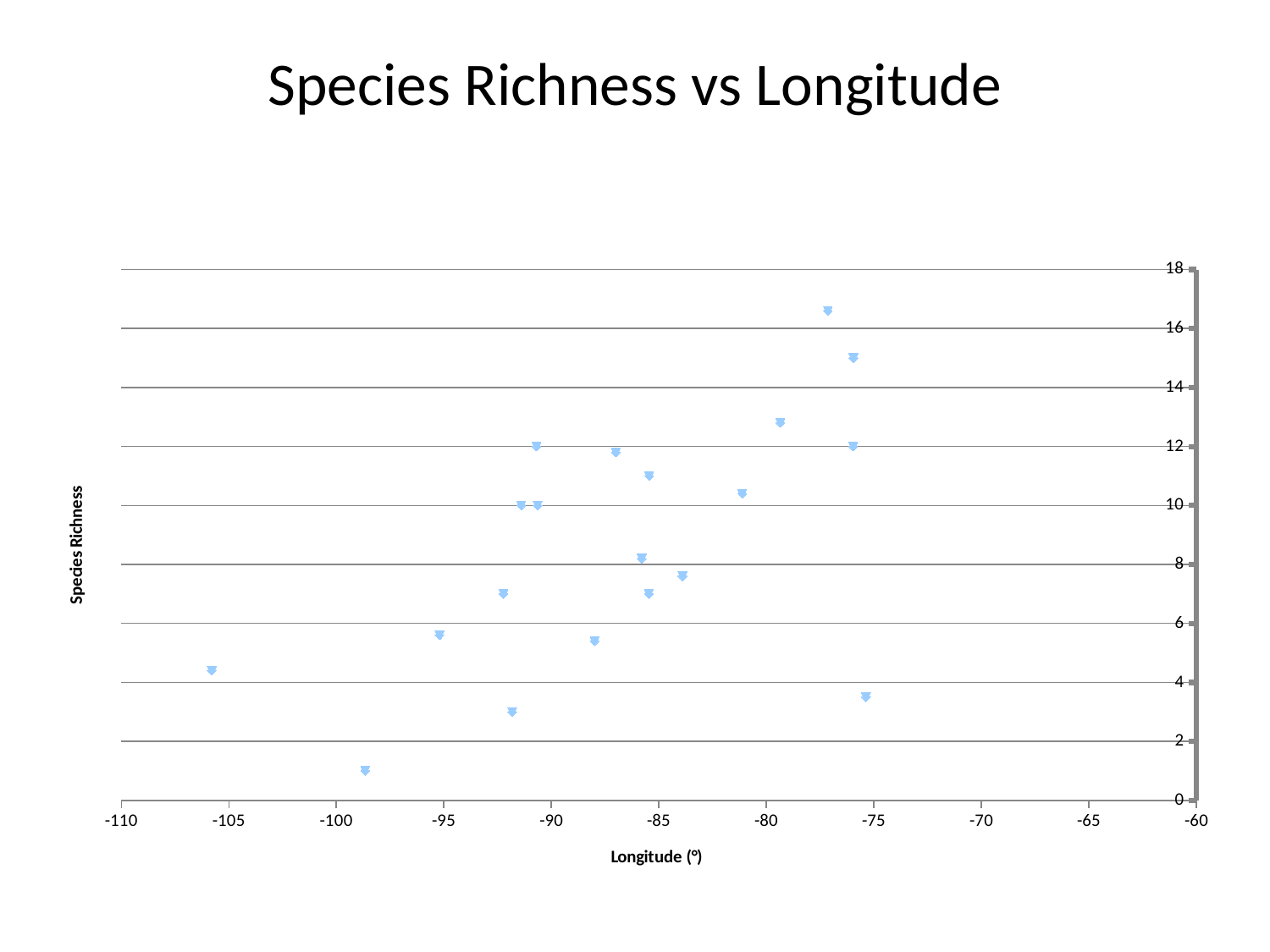
How many data points are plotted on the chart? 20 What is the title of the chart? Species Richness vs Longitude What is the label of the x axis? Longitude (°) Is the species richness of the point near longitude -77 greater or less than 16? greater Is the species richness of the highest point on the chart greater or less than 16? greater Is the species richness of the point near longitude -105 greater or less than 4? greater Overall, does species richness tend to rise or fall as longitude increases from -110 toward -60? rise What is the maximum value shown on the species richness axis? 18 What kind of chart is shown on the slide? scatter plot